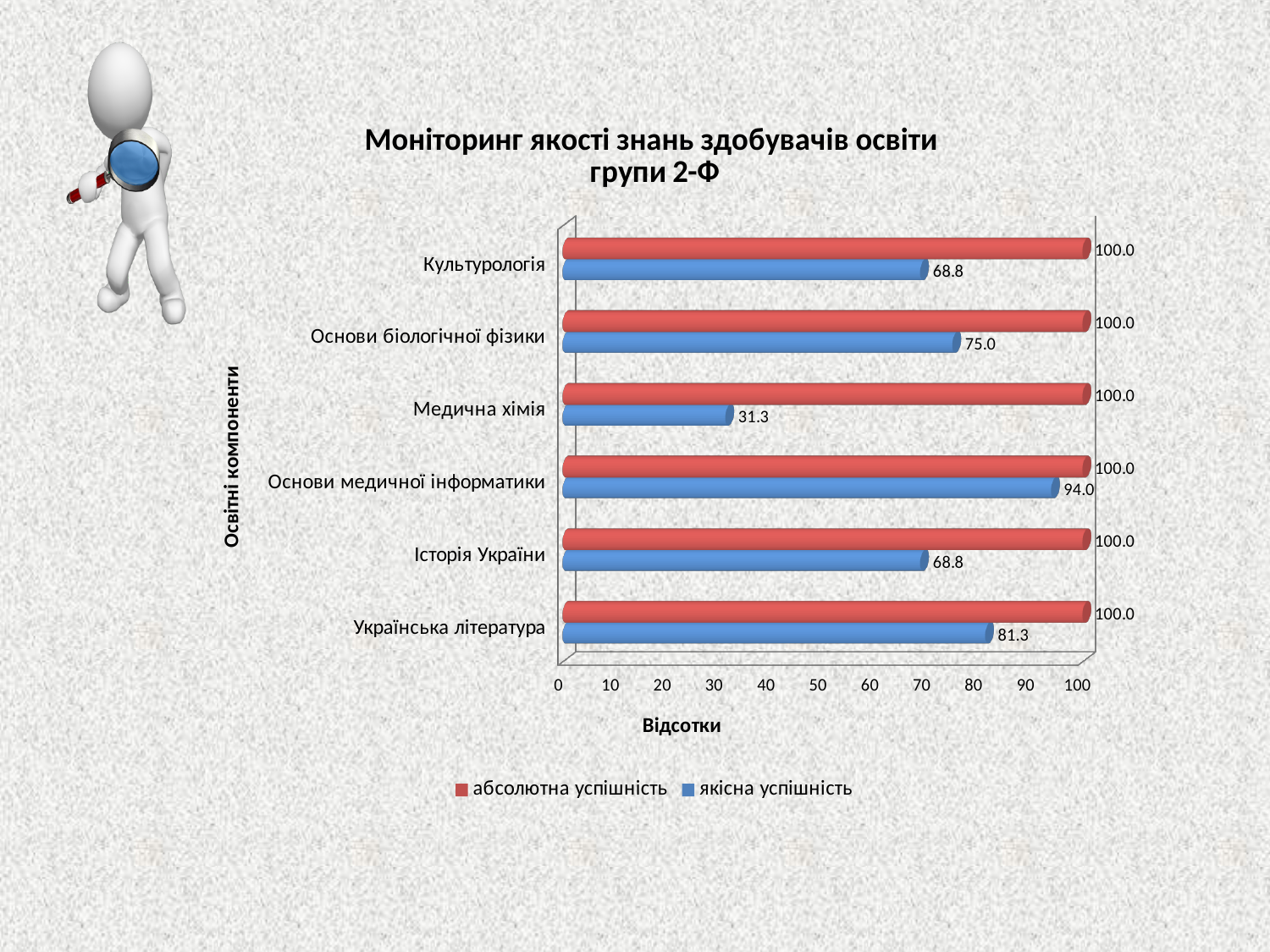
How many series does the legend list? 2 What is the label of the horizontal axis? Відсотки How many categories are shown on the chart? 6 Which category has the lowest якісна успішність value? Медична хімія Which is larger: the якісна успішність value for Українська література or for Історія України? Українська література What kind of chart is shown on the slide? Bar chart Which category has the highest якісна успішність value? Основи медичної інформатики What is the абсолютна успішність value for Культурологія? 100.0 What is the difference between the якісна успішність values for Основи біологічної фізики and Медична хімія? 43.7 What is the якісна успішність value for Медична хімія? 31.3 What is the якісна успішність value for Українська література? 81.3 What is the якісна успішність value for Основи медичної інформатики? 94.0